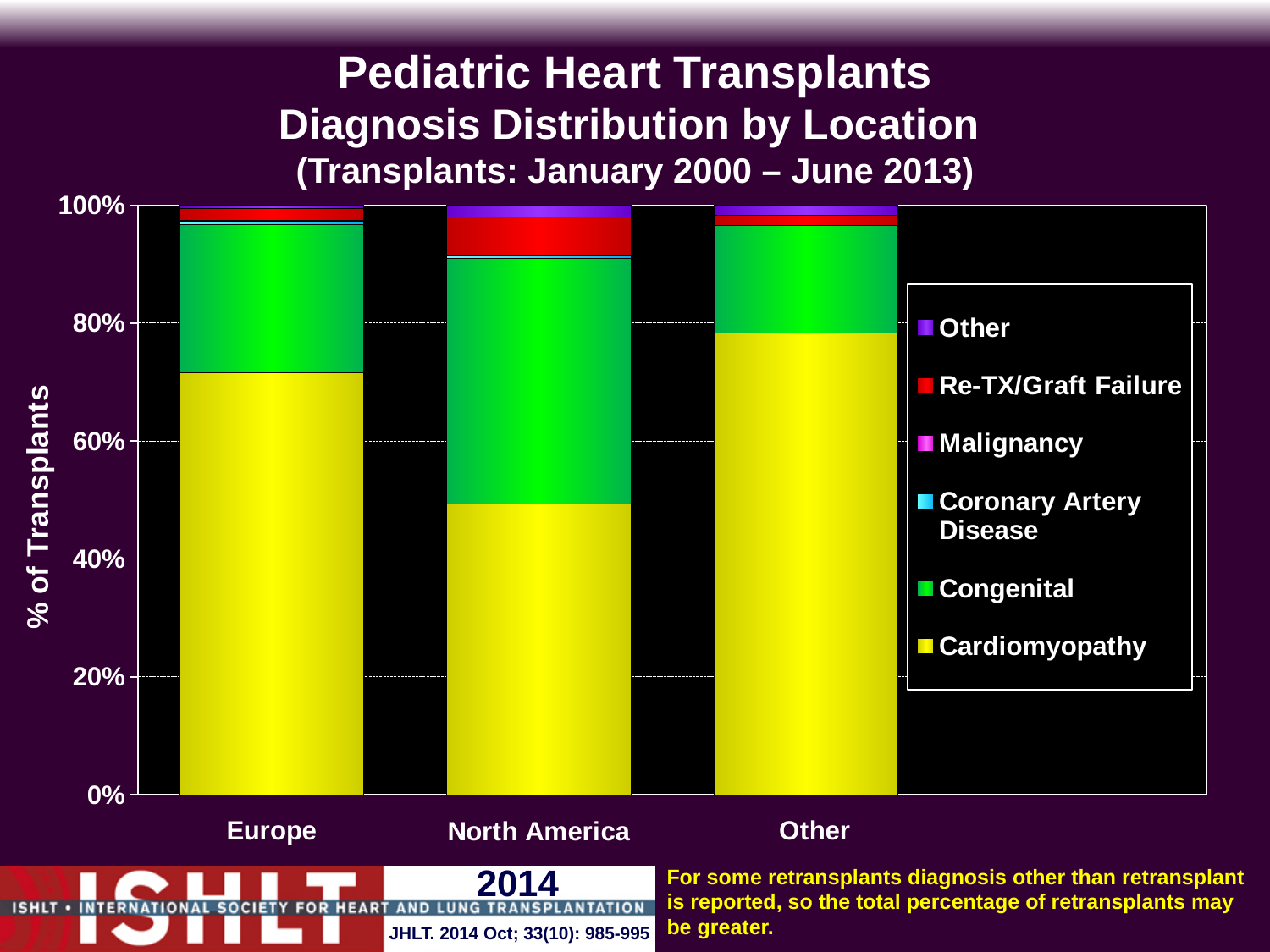
How many diagnosis series does the legend list? 6 What is the title of the chart? Pediatric Heart Transplants Diagnosis Distribution by Location (Transplants: January 2000 – June 2013) Which location has a larger Cardiomyopathy share, Europe or North America? Europe What kind of chart is shown on the slide? Stacked bar chart Is the Cardiomyopathy share for North America greater or less than 60%? less Which location has the smallest Cardiomyopathy share? North America Which location has the largest Congenital share? North America Which colour represents Cardiomyopathy in the legend? Yellow How many location categories are shown on the x axis? 3 Is the Cardiomyopathy share for Europe greater or less than 60%? greater Which location has the largest Re-TX/Graft Failure share? North America Which location has the largest Cardiomyopathy share? Other